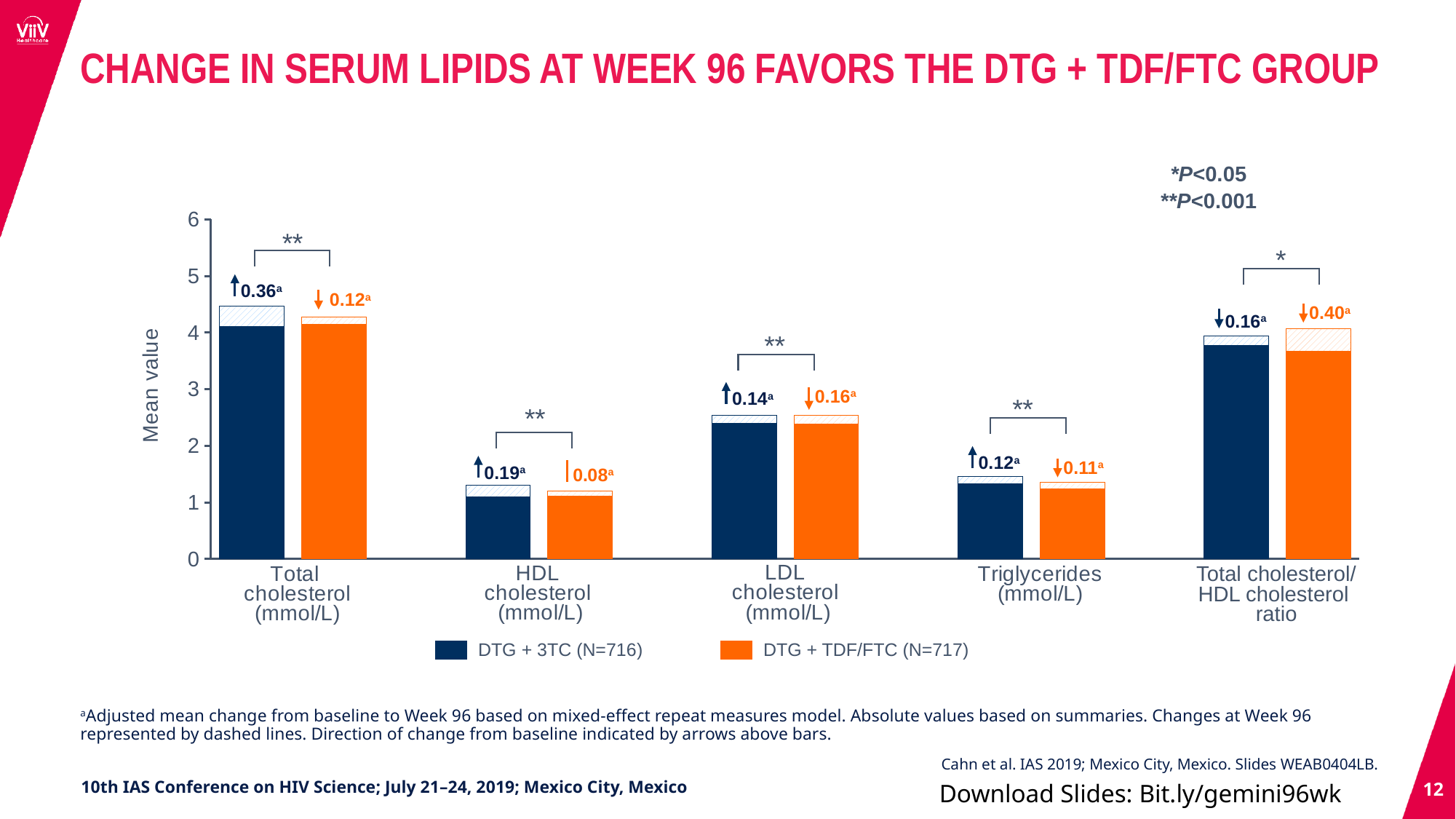
What kind of chart is shown on the slide? bar chart What is the difference between the labelled changes from baseline for DTG + 3TC (0.36) and DTG + TDF/FTC (0.12) in total cholesterol? 0.24 What is the labelled change from baseline for DTG + TDF/FTC in LDL cholesterol (mmol/L)? 0.16 Is the mean value for DTG + TDF/FTC in triglycerides (mmol/L) greater or less than 2? less What is the labelled change from baseline for DTG + TDF/FTC in the total cholesterol/HDL cholesterol ratio? 0.40 What is the y-axis title of the chart? Mean value What is the labelled change from baseline for DTG + 3TC in HDL cholesterol (mmol/L)? 0.19 What is the labelled change from baseline for DTG + 3TC in total cholesterol (mmol/L)? 0.36 How many series does the legend list? 2 Which category has the highest mean values for both groups? Total cholesterol (mmol/L) Which category has the lowest mean values for both groups? HDL cholesterol (mmol/L) How many lipid categories are shown on the x axis? 5